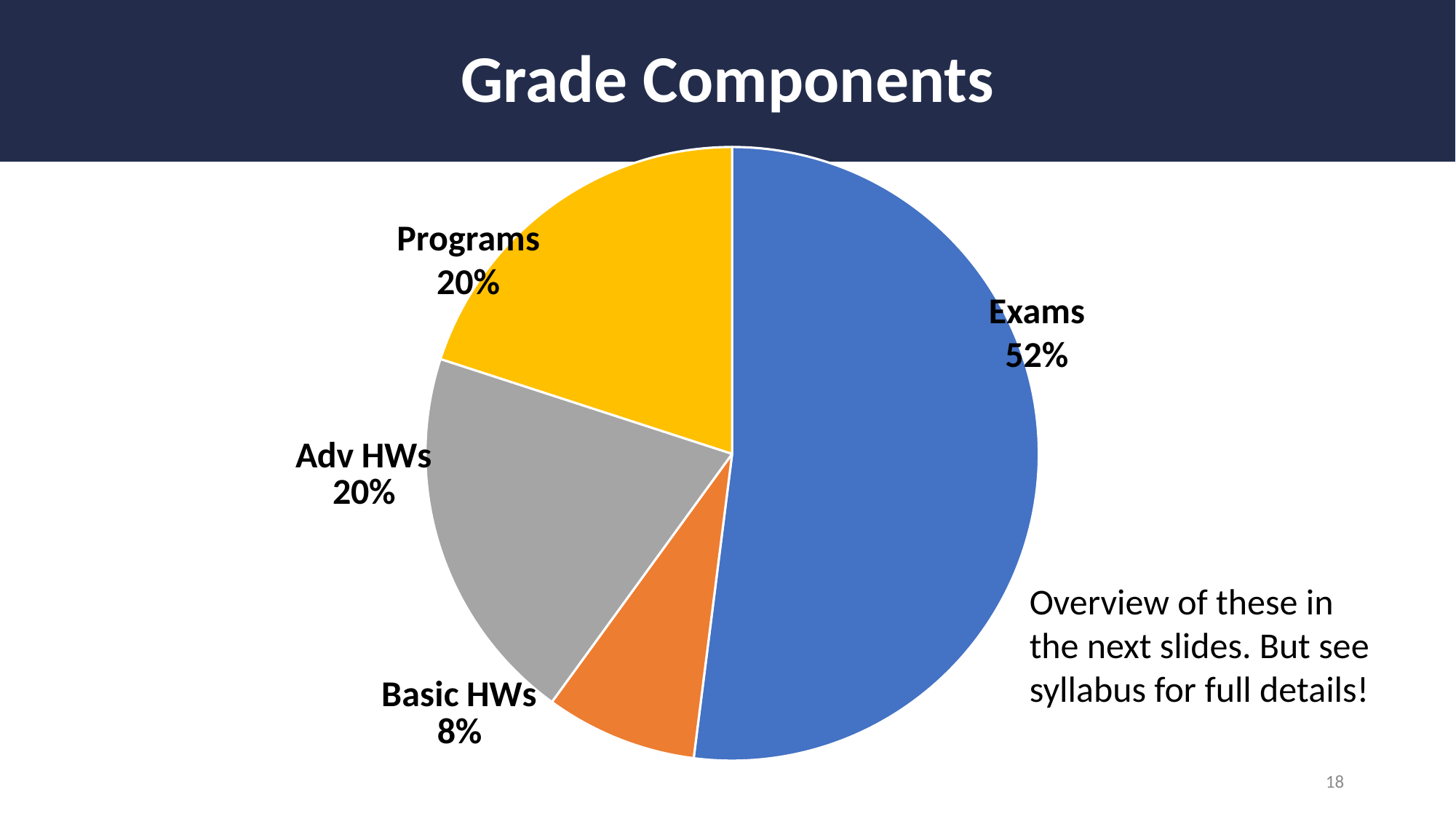
What is the difference in percentage points between Exams and Programs? 32 What share of the grade do Exams account for? 52% What percentage of the grade is Adv HWs? 20% How many grade components are shown in the pie chart? 4 What type of chart is shown on the slide? Pie chart What is the difference in percentage points between Adv HWs and Basic HWs? 12 Which is larger, the share for Exams or the share for Adv HWs? Exams Which grade component has the smallest share? Basic HWs What is the title of the slide containing the chart? Grade Components What percentage of the grade is Basic HWs? 8% What percentage of the grade is Programs? 20% Which grade component has the largest share? Exams